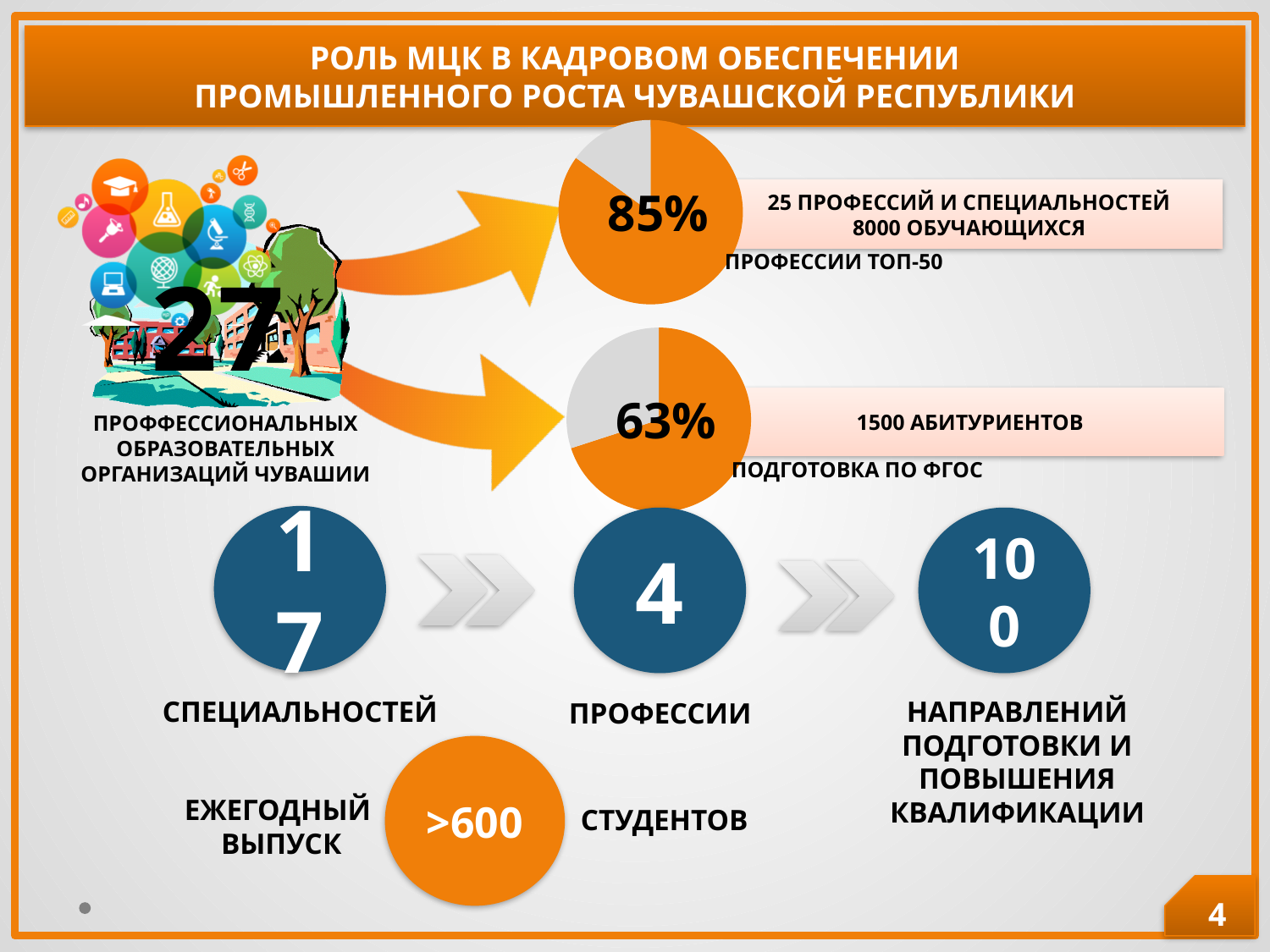
What kind of chart is the lower chart labelled 63% (ПОДГОТОВКА ПО ФГОС)? pie chart How many slices does the lower pie chart (ПОДГОТОВКА ПО ФГОС) have? 2 Which pie chart has the larger orange slice, the upper one (ПРОФЕССИИ ТОП-50) or the lower one (ПОДГОТОВКА ПО ФГОС)? the upper one (ПРОФЕССИИ ТОП-50) In the upper pie chart (ПРОФЕССИИ ТОП-50), what share does the grey slice represent? 15% In the upper pie chart (ПРОФЕССИИ ТОП-50), what share does the orange slice represent? 85% What is the difference in percentage points between the value shown in the upper pie chart (85%) and the lower pie chart (63%)? 22 percentage points In the lower pie chart (ПОДГОТОВКА ПО ФГОС), what share does the orange slice represent? 63% What colour is the larger slice in the lower pie chart (ПОДГОТОВКА ПО ФГОС)? orange What kind of chart is the upper chart labelled 85% (ПРОФЕССИИ ТОП-50)? pie chart Is the value shown in the lower pie chart (ПОДГОТОВКА ПО ФГОС) greater or less than 50%? greater How many slices does the upper pie chart (ПРОФЕССИИ ТОП-50) have? 2